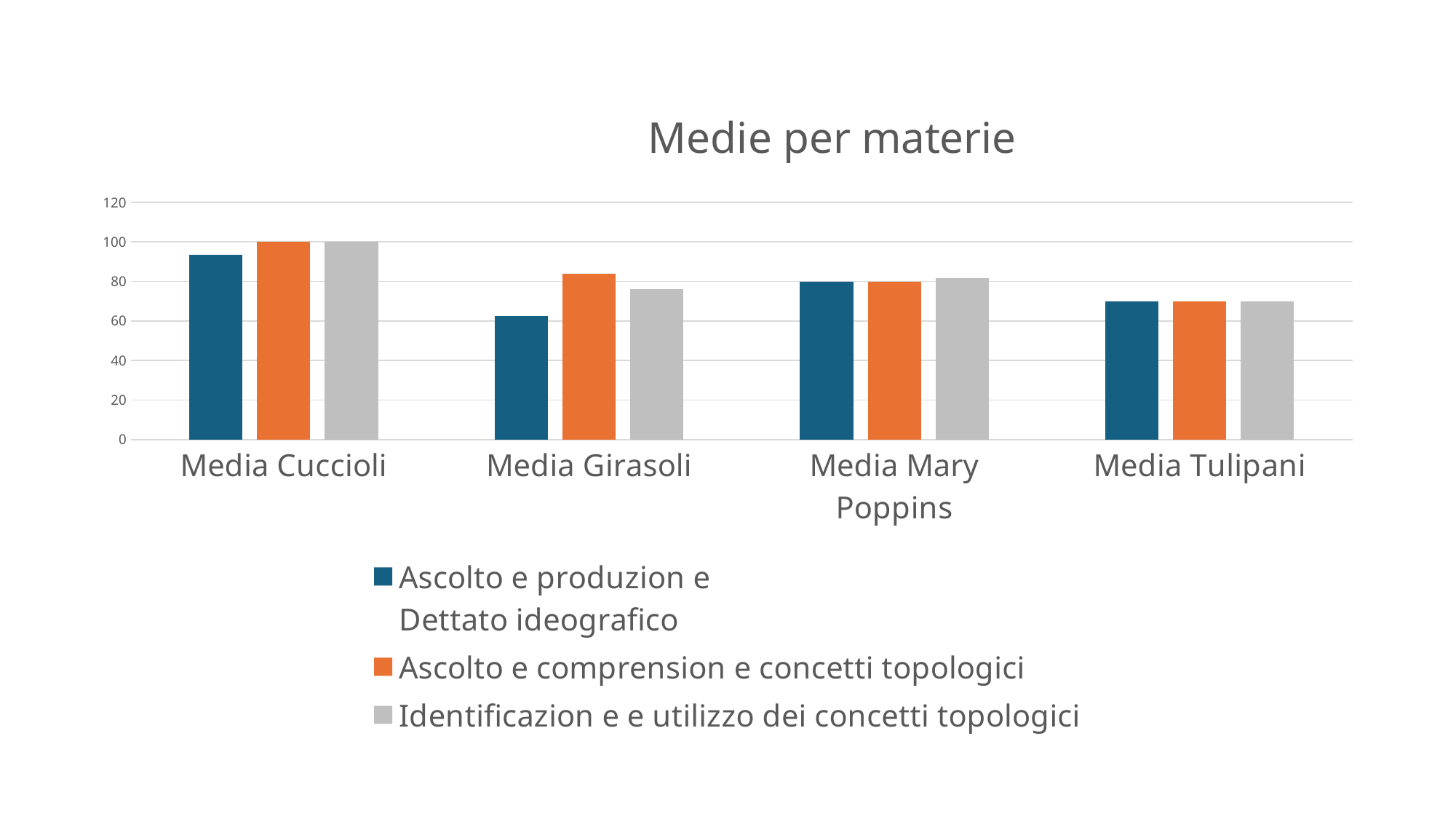
How many series does the legend list? 3 Is the value of 'Ascolto e produzion e Dettato ideografico' for Media Girasoli greater or less than 80? less Which colour represents 'Identificazion e e utilizzo dei concetti topologici' in the legend? grey What is the value of 'Ascolto e comprension e concetti topologici' for Media Cuccioli? 100 What is the title of the chart? Medie per materie Which category has the lowest value for 'Ascolto e produzion e Dettato ideografico'? Media Girasoli What is the value of 'Identificazion e e utilizzo dei concetti topologici' for Media Cuccioli? 100 Is the value of 'Ascolto e comprension e concetti topologici' for Media Girasoli greater or less than 80? greater Which category has the highest value for 'Ascolto e produzion e Dettato ideografico'? Media Cuccioli What kind of chart is shown on the slide? bar chart For Media Girasoli, which is larger: 'Ascolto e produzion e Dettato ideografico' or 'Ascolto e comprension e concetti topologici'? Ascolto e comprension e concetti topologici How many categories are shown on the x axis of the chart? 4